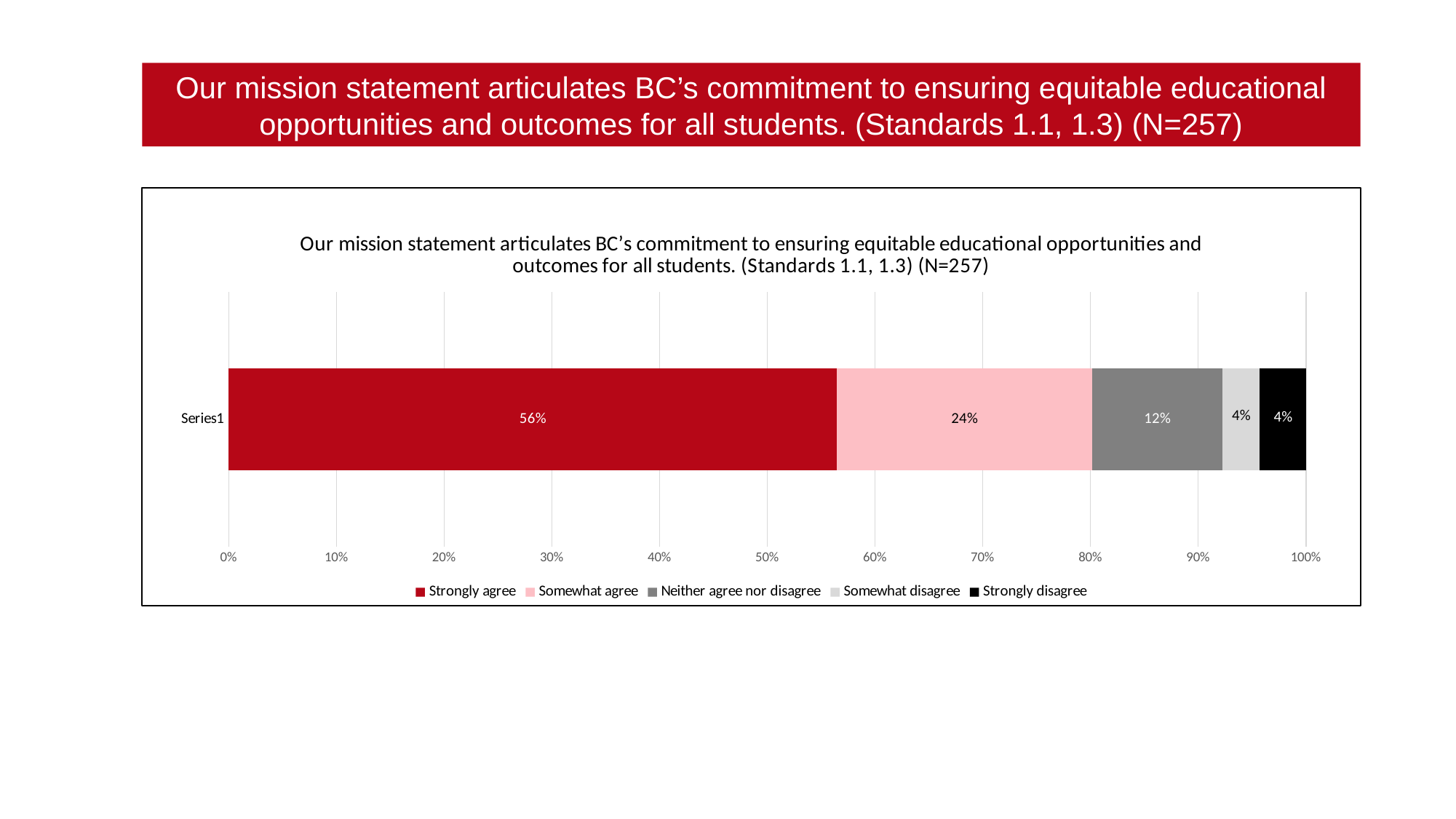
Which response category has the largest share? Strongly agree What is the difference between the "Strongly agree" and "Somewhat agree" percentages? 32% What percentage of respondents selected "Neither agree nor disagree"? 12% What colour is the "Strongly disagree" segment? Black What percentage of respondents selected "Somewhat agree"? 24% Which is larger, the "Somewhat agree" share or the "Neither agree nor disagree" share? Somewhat agree What percentage of respondents selected "Strongly disagree"? 4% What is the difference between the "Somewhat agree" and "Neither agree nor disagree" percentages? 12% What kind of chart is shown on the slide? Stacked bar chart What percentage of respondents selected "Strongly agree"? 56% What is the total of the stacked bar when all five segments are added together? 100% How many series does the legend list? 5